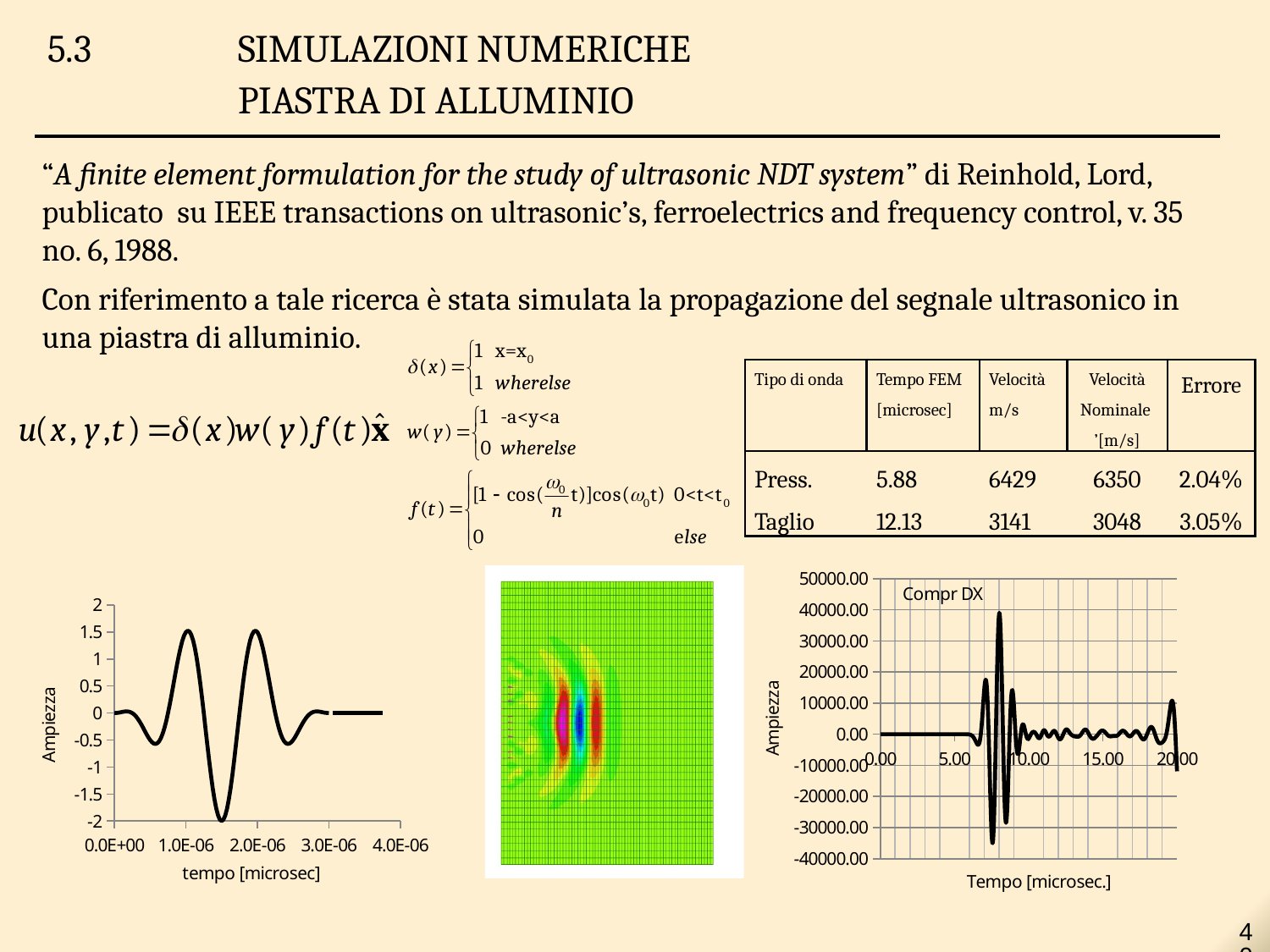
In the Compr DX chart, is the value at time 5.00 greater or less than 10000.00? less In the chart on the left of the slide, is the value at 3.0E-06 greater or less than 1? less What is the title shown inside the chart on the right of the slide? Compr DX What is the x-axis title of the chart on the left of the slide? tempo [microsec] What kind of chart is the chart on the left of the slide (Ampiezza vs tempo [microsec])? line chart In the chart on the left of the slide, is the highest peak of the signal greater or less than 1? greater What kind of chart is the chart on the right of the slide (Compr DX)? line chart